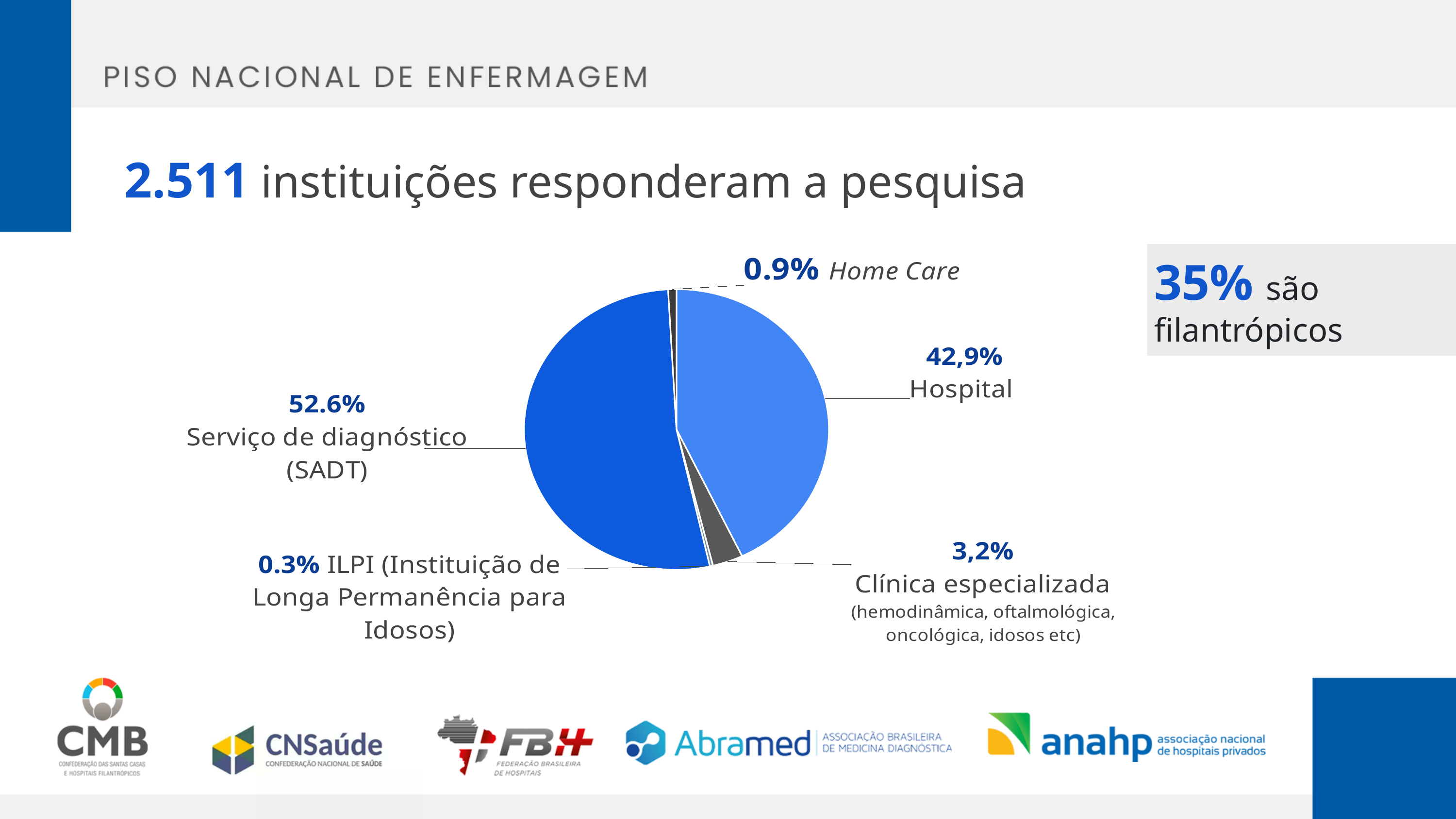
Which category has the smallest slice of the pie chart? ILPI (Instituição de Longa Permanência para Idosos) What share of the pie chart is ILPI (Instituição de Longa Permanência para Idosos)? 0.3% What kind of chart is shown on the slide? pie chart Which is larger in the pie chart, Home Care or ILPI? Home Care What share of the pie chart is Home Care? 0.9% Which category has the largest slice of the pie chart? Serviço de diagnóstico (SADT) According to the slide, how many institutions responded to the survey? 2.511 Which is larger in the pie chart, Hospital or Clínica especializada? Hospital What share of the pie chart is Hospital? 42,9% How many slices does the pie chart have? 5